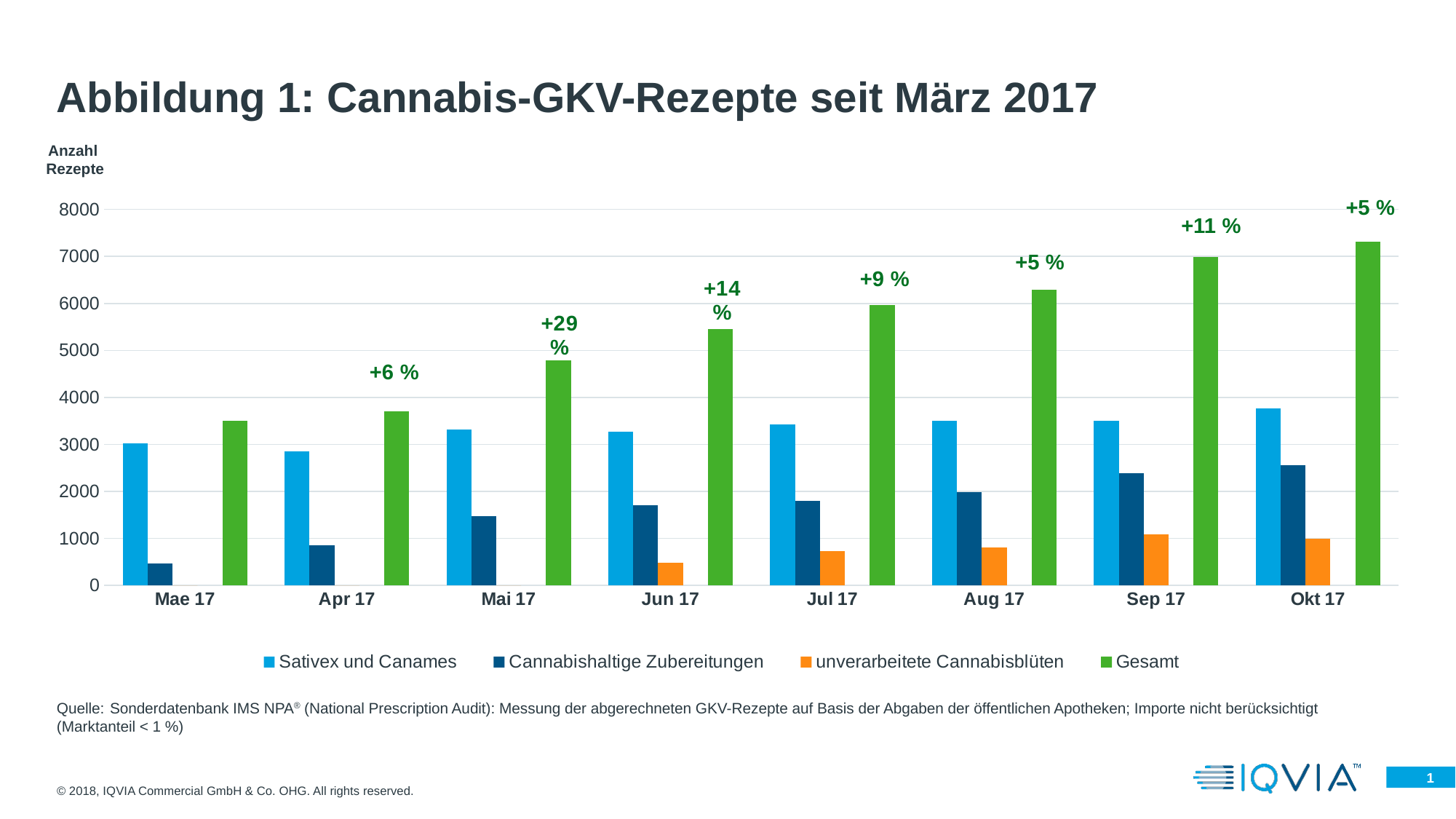
What growth percentage is printed above the Gesamt bar for Sep 17? +11 % Does the Gesamt series rise or fall from Mae 17 to Okt 17? rise Is the value for Cannabishaltige Zubereitungen in Okt 17 greater or less than 2000? greater Is the Gesamt value for Mae 17 greater or less than 4000? less Which month has the lowest Gesamt value? Mae 17 How many series does the chart legend list? 4 Which month has the highest Gesamt value? Okt 17 What growth percentage is printed above the Gesamt bar for Mai 17? +29 % How many months are shown on the x axis of the chart? 8 What kind of chart is shown on the slide? bar chart In Okt 17, which is larger: Sativex und Canames or Cannabishaltige Zubereitungen? Sativex und Canames Is the Gesamt value for Okt 17 greater or less than 7000? greater